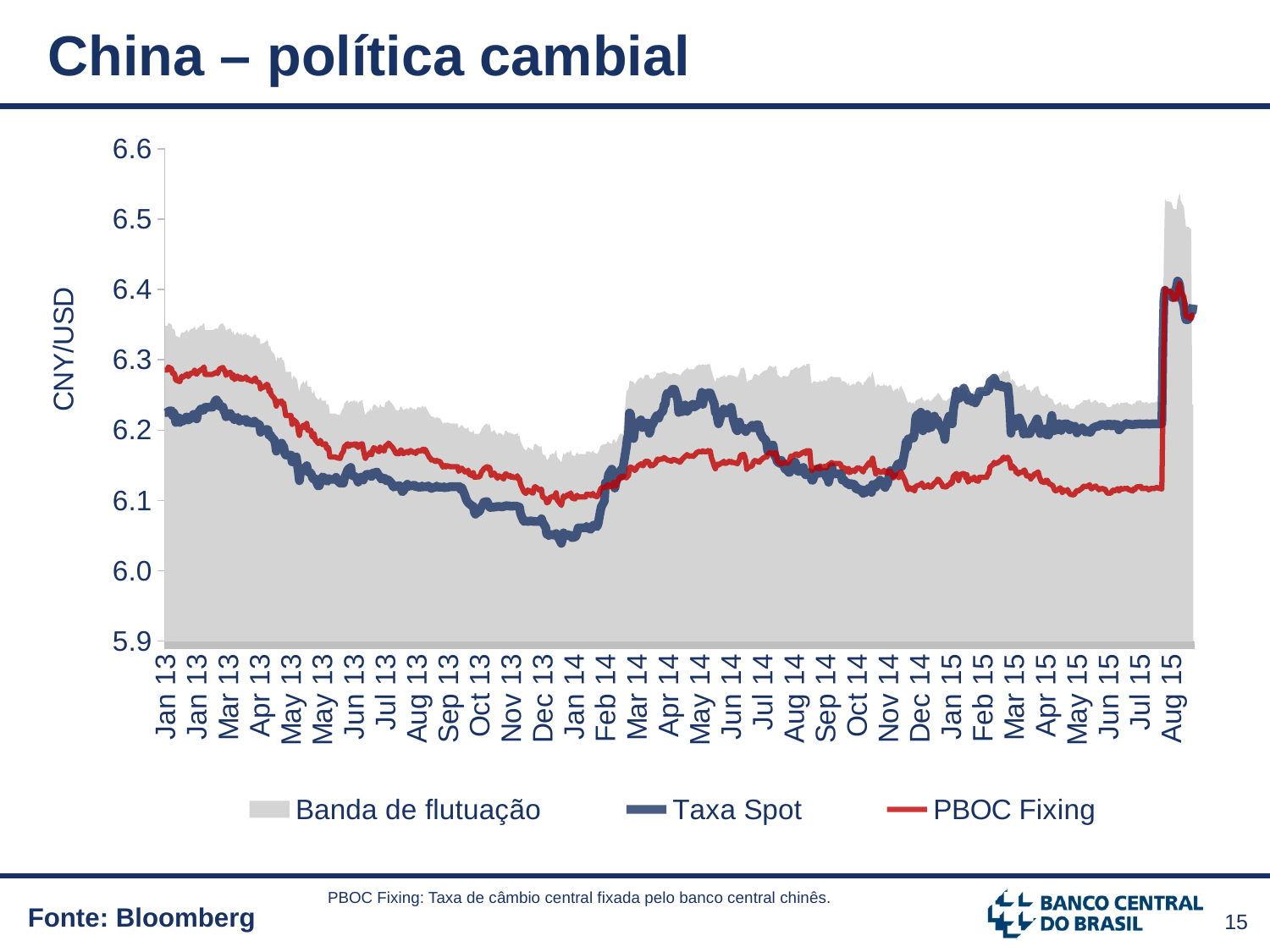
What kind of chart is shown on the slide? line chart Does the Taxa Spot line rise or fall between Jan 13 and Dec 13? fall In Jan 13, which is higher, Taxa Spot or PBOC Fixing? PBOC Fixing Which legend entry is shown as a grey shaded area? Banda de flutuação Is the Taxa Spot value in Dec 13 greater or less than 6.1? less Does the Taxa Spot line rise or fall between Jul 15 and Aug 15? rise Is the Taxa Spot value in Aug 15 greater or less than 6.3? greater Is the PBOC Fixing value in Jul 15 greater or less than 6.2? less How many entries does the legend list? 3 In Apr 14, which is higher, Taxa Spot or PBOC Fixing? Taxa Spot What is the label on the vertical axis? CNY/USD